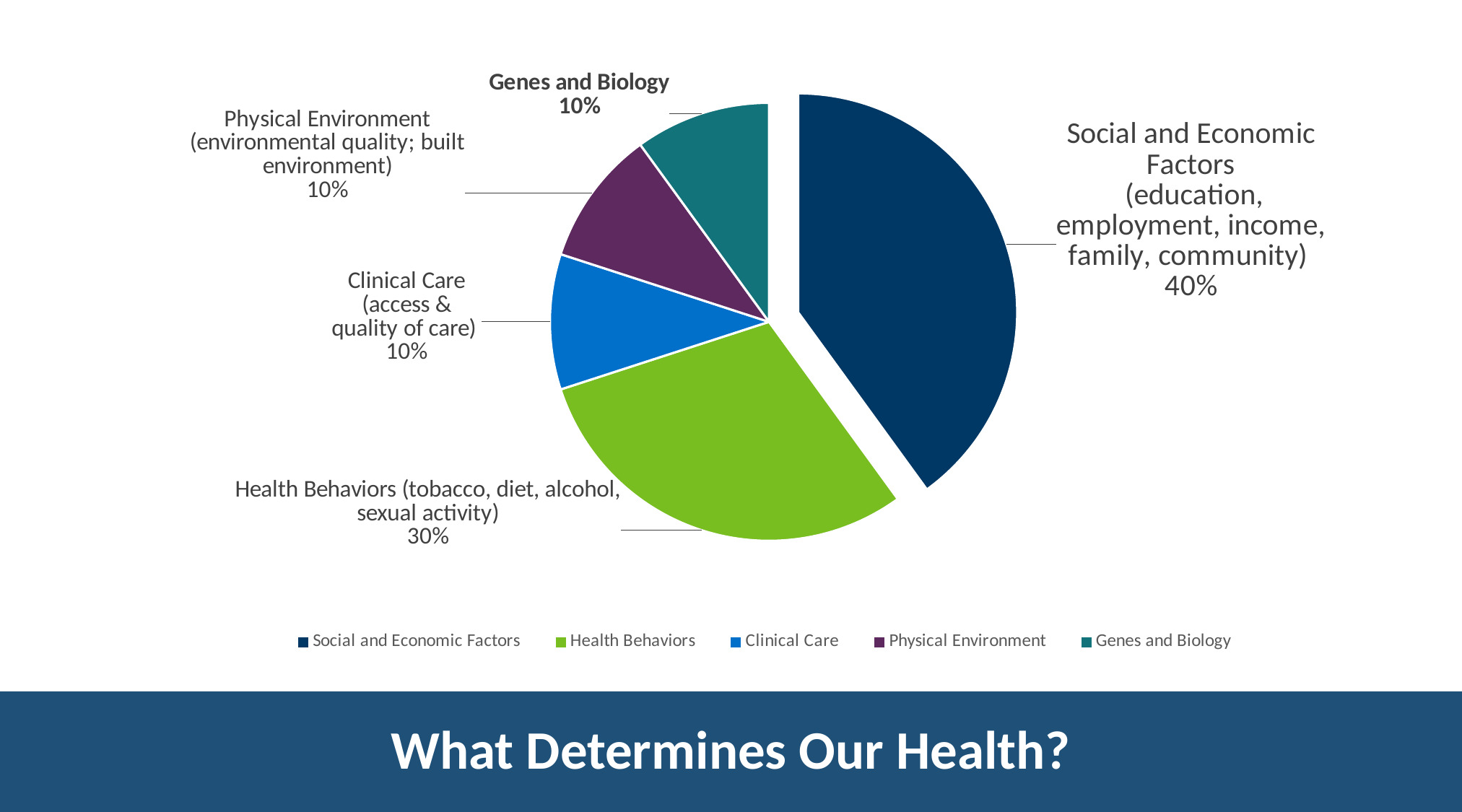
What type of chart is shown on the slide? pie chart What is the difference in percentage points between Social and Economic Factors and Health Behaviors? 10 How many slices does the pie chart have? 5 Which slice is pulled out (exploded) from the rest of the pie? Social and Economic Factors What share of the pie is Health Behaviors? 30% What share of the pie is Genes and Biology? 10% How many entries does the legend list? 5 What share of the pie is Social and Economic Factors? 40% Which is larger, Health Behaviors or Physical Environment? Health Behaviors What share of the pie is Clinical Care? 10% What is the combined share of Clinical Care, Physical Environment and Genes and Biology? 30% Which category has the largest slice of the pie? Social and Economic Factors